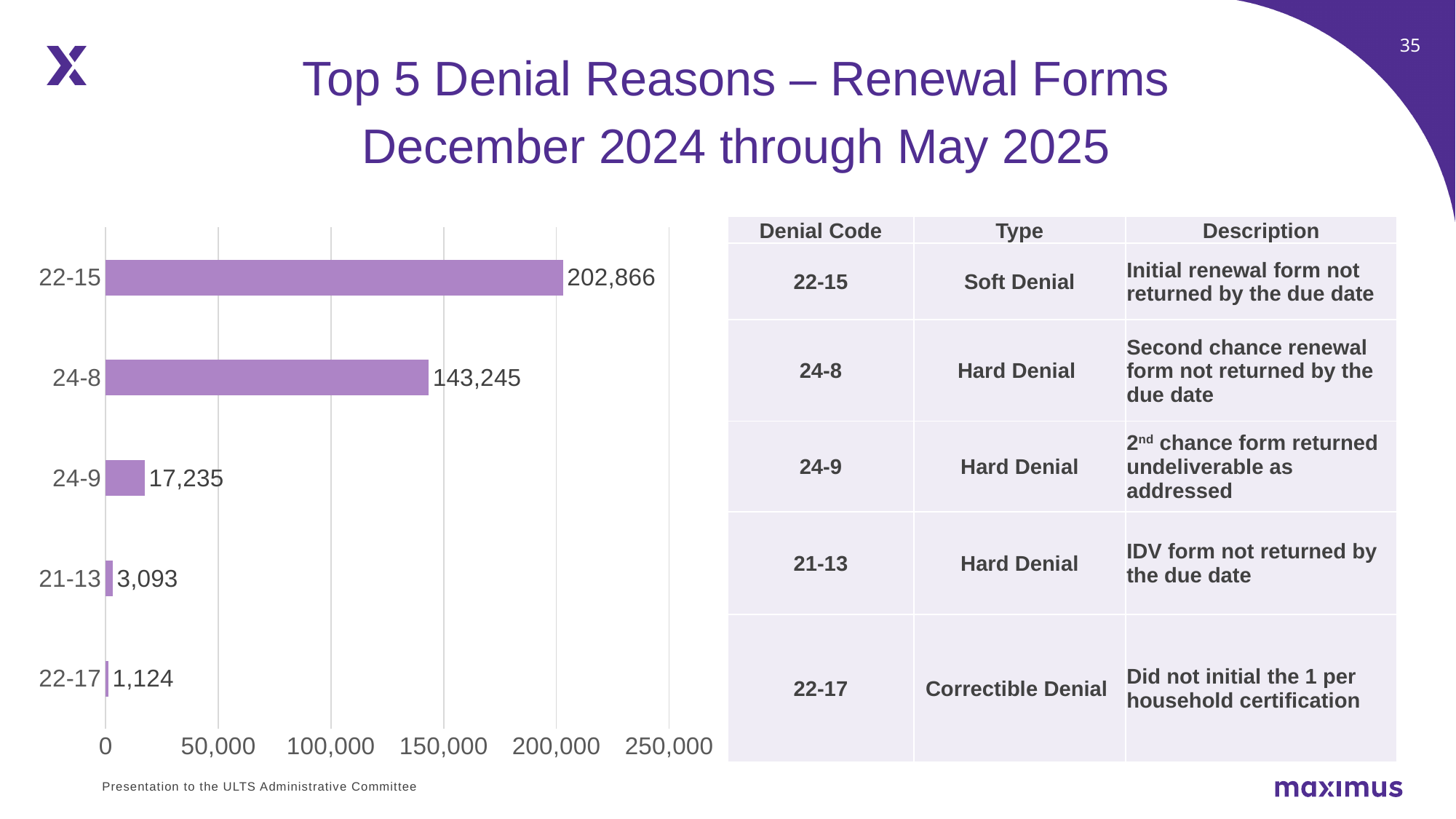
Which has a larger value, 24-9 or 21-13? 24-9 What kind of chart is shown on the slide? bar chart Is the value for 24-8 greater or less than 150,000? less How many denial codes are shown in the chart? 5 Which denial code has the highest value? 22-15 What is the difference between the values for 22-15 and 24-8? 59,621 What is the maximum value shown on the chart's horizontal axis? 250,000 What is the value for denial code 22-15? 202,866 What is the value for denial code 24-9? 17,235 Which denial code has the lowest value? 22-17 What is the value for denial code 24-8? 143,245 What is the value for denial code 22-17? 1,124